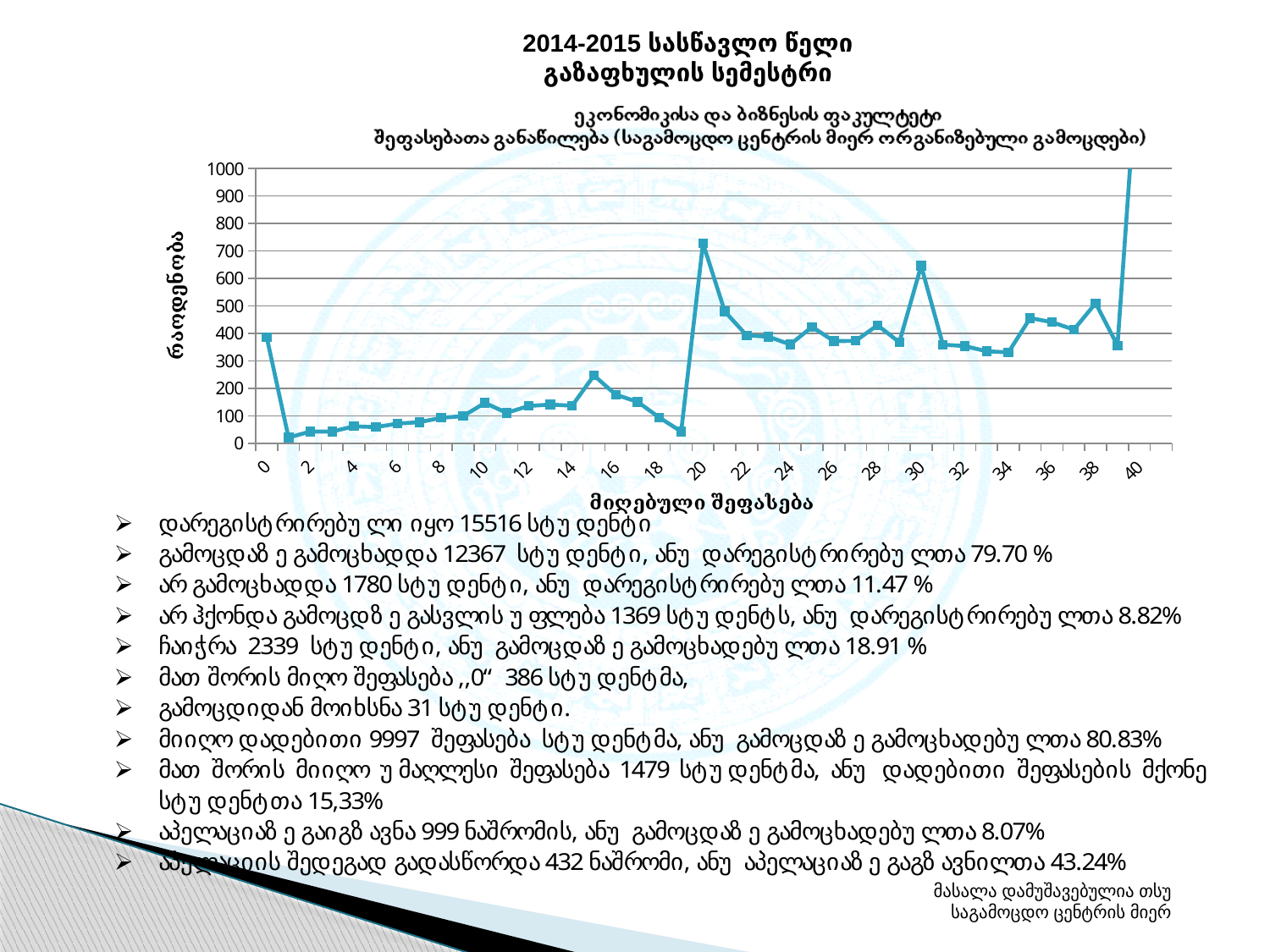
Is the value at x = 19 greater or less than 100? less Do the values generally rise or fall from x = 1 to x = 15? rise Is the value at x = 1 greater or less than 100? less Is the value at x = 15 greater or less than 200? greater Which is larger, the value at x = 15 or the value at x = 16? x = 15 What is the highest tick value shown on the vertical axis? 1000 What is the label on the vertical axis? რაოდენობა What kind of chart is shown on the slide? line chart Which is larger, the value at x = 20 or the value at x = 30? x = 20